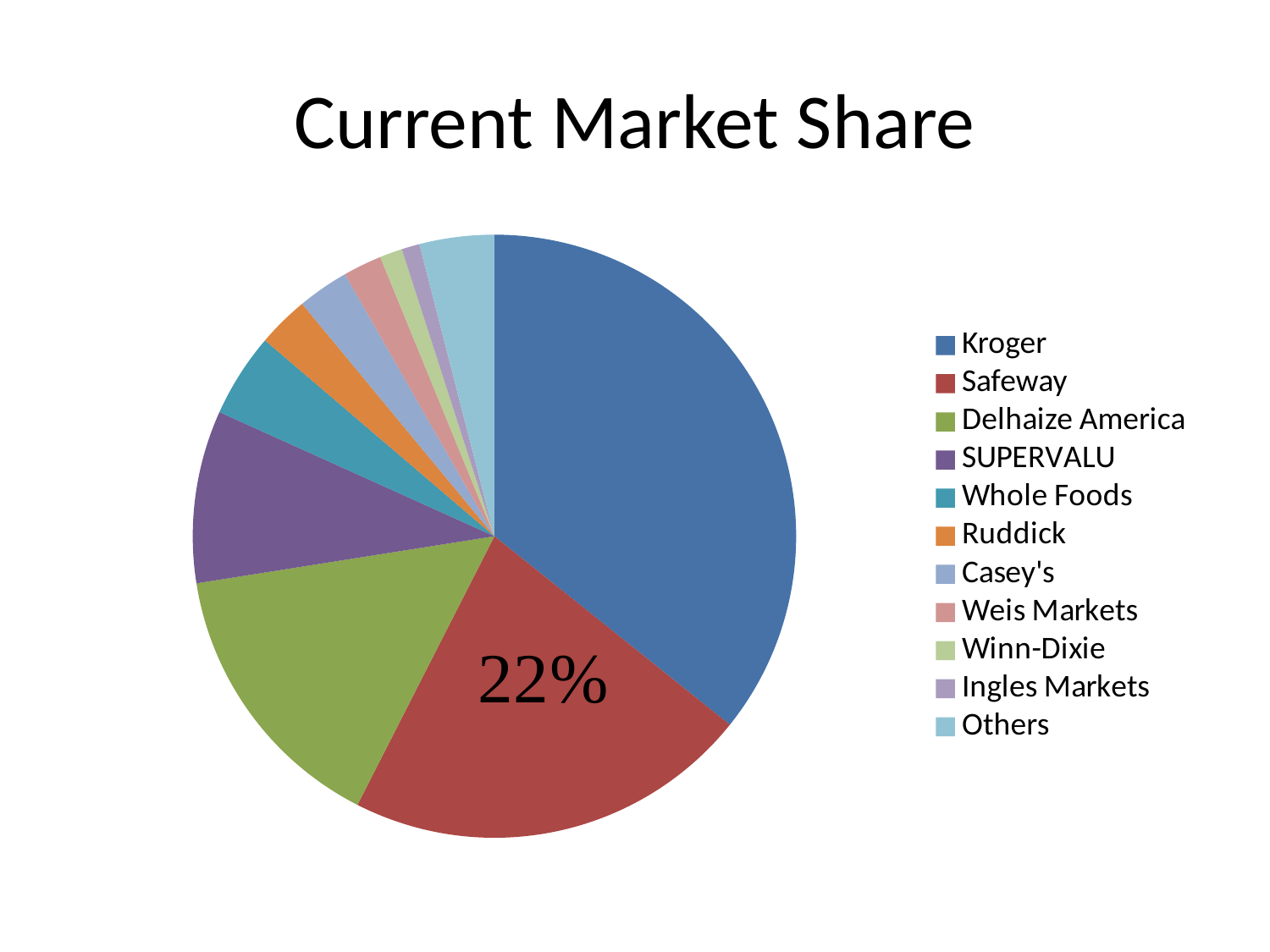
Which category has the largest slice of the pie? Kroger What share of the pie does Safeway hold? 22% What colour is the Kroger slice? blue Which slice is larger, Kroger or Safeway? Kroger Which slice is larger, Whole Foods or Ruddick? Whole Foods Which slice is larger, Others or Casey's? Others How many categories does the legend list? 11 What kind of chart is shown on the slide? pie chart Which category's slice carries the only printed data label? Safeway What is the title of the chart? Current Market Share